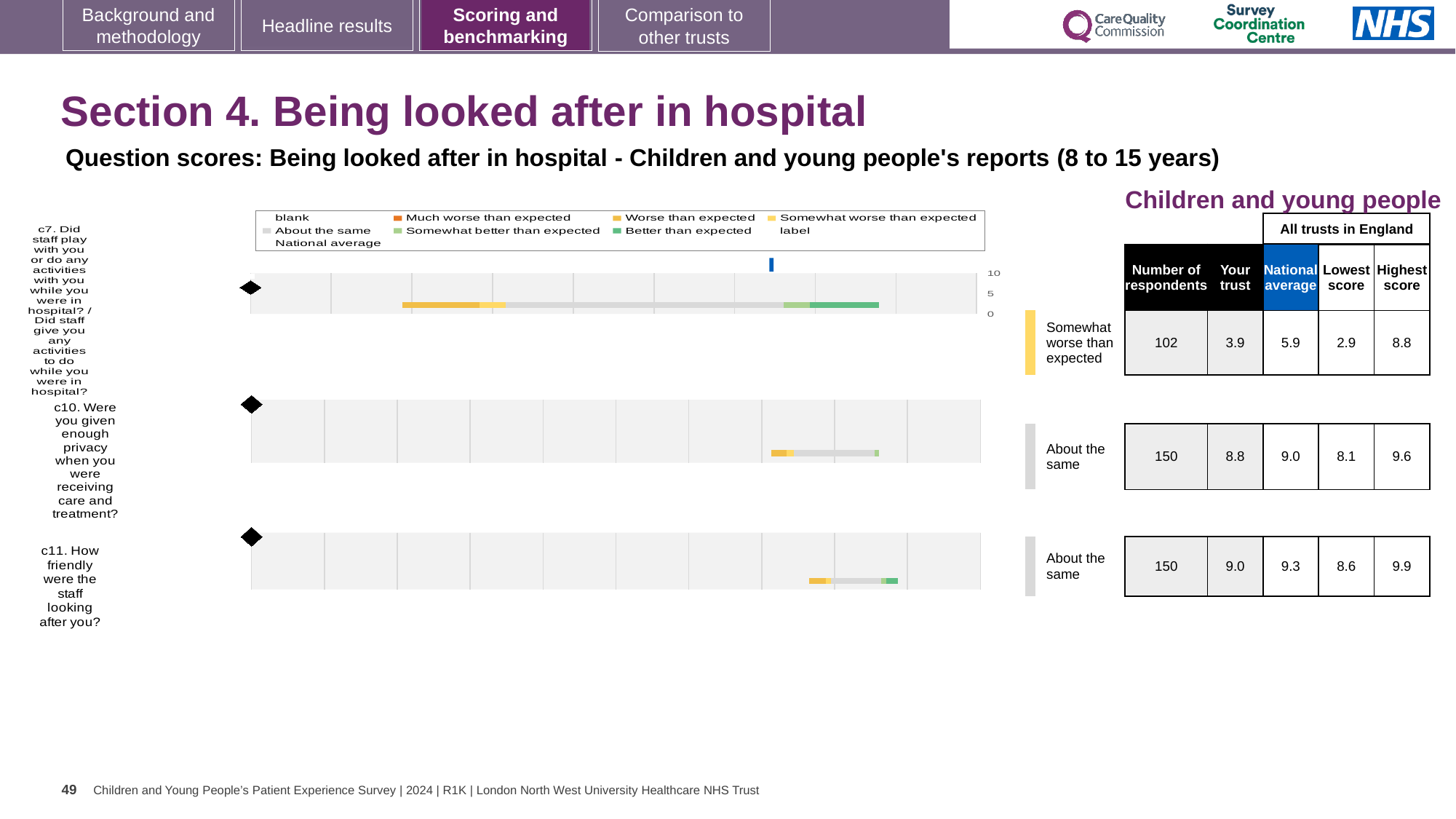
For question c7, which is larger: the 'Your trust' score or the national average? National average What benchmark category label is shown for question c7? Somewhat worse than expected Which question has the highest 'Your trust' score? c11 How many respondents answered question c7? 102 What is the difference between the highest and lowest scores for question c11? 1.3 How many survey questions are plotted on the slide? 3 Which question has the lowest 'Your trust' score? c7 What is the national average score for question c10 (Were you given enough privacy when you were receiving care and treatment?)? 9.0 Is the 'Your trust' score for question c7 greater or less than 5? less What is the 'Your trust' score for question c7 (Did staff play with you or do any activities with you while you were in hospital?)? 3.9 What kind of chart is used to show the question scores for c7, c10 and c11? Bar chart What is the highest score across all trusts in England for question c11 (How friendly were the staff looking after you?)? 9.9